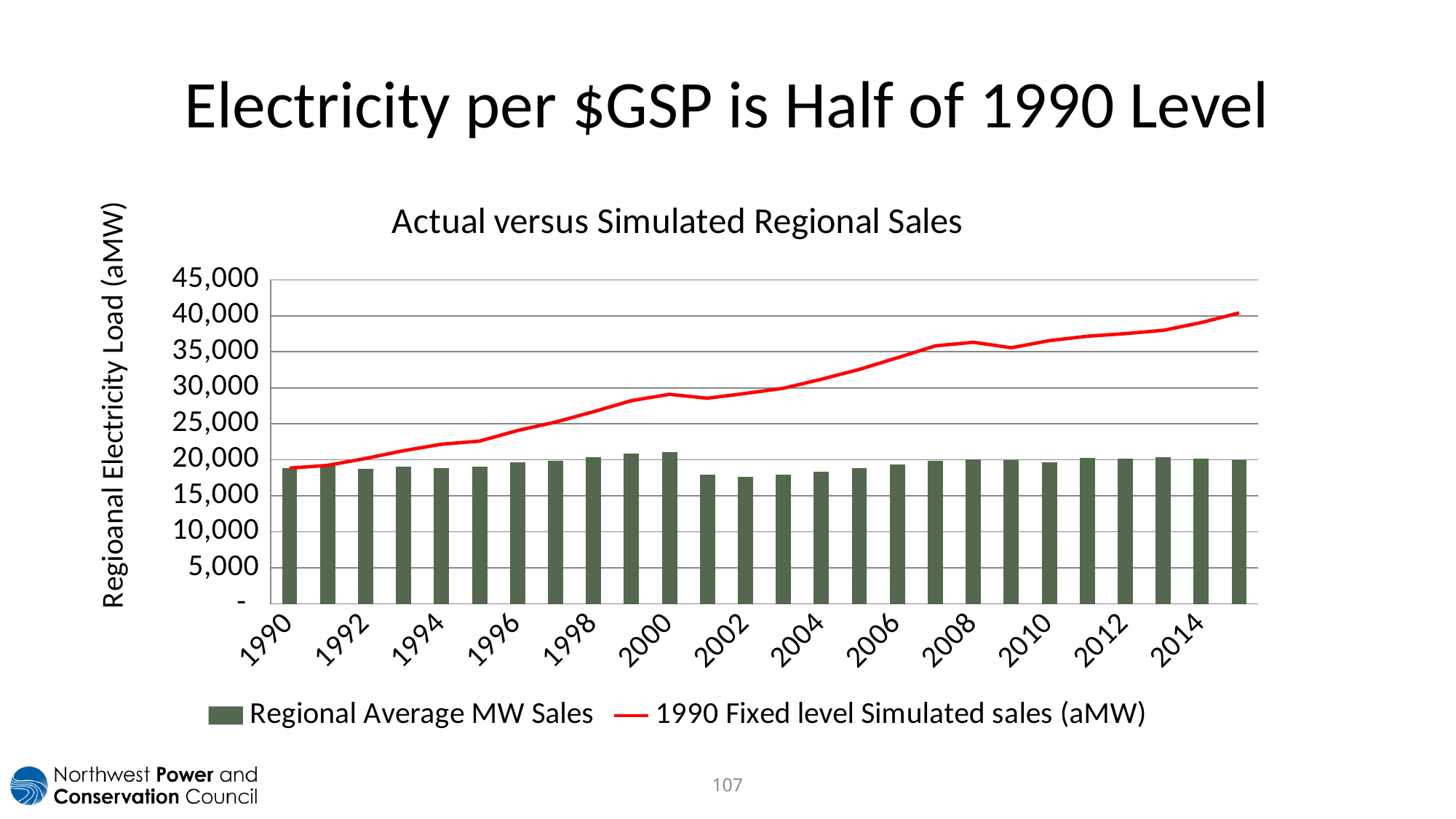
Does the 1990 Fixed level Simulated sales line generally rise or fall from 1990 to 2015? Rise Is the 1990 Fixed level Simulated sales value for 2000 greater or less than 25,000? greater Which series is drawn as a red line? 1990 Fixed level Simulated sales (aMW) Is the Regional Average MW Sales value for 2002 greater or less than 20,000? less How many bars are plotted for Regional Average MW Sales? 26 Is the 1990 Fixed level Simulated sales value for 2014 greater or less than 35,000? greater How many series does the legend list? 2 What is the title of the chart? Actual versus Simulated Regional Sales In 2010, which is larger: the Regional Average MW Sales bar or the 1990 Fixed level Simulated sales line? 1990 Fixed level Simulated sales line Which is larger: the Regional Average MW Sales value for 2000 or for 2002? 2000 What kind of chart is shown on the slide? A combination bar and line chart